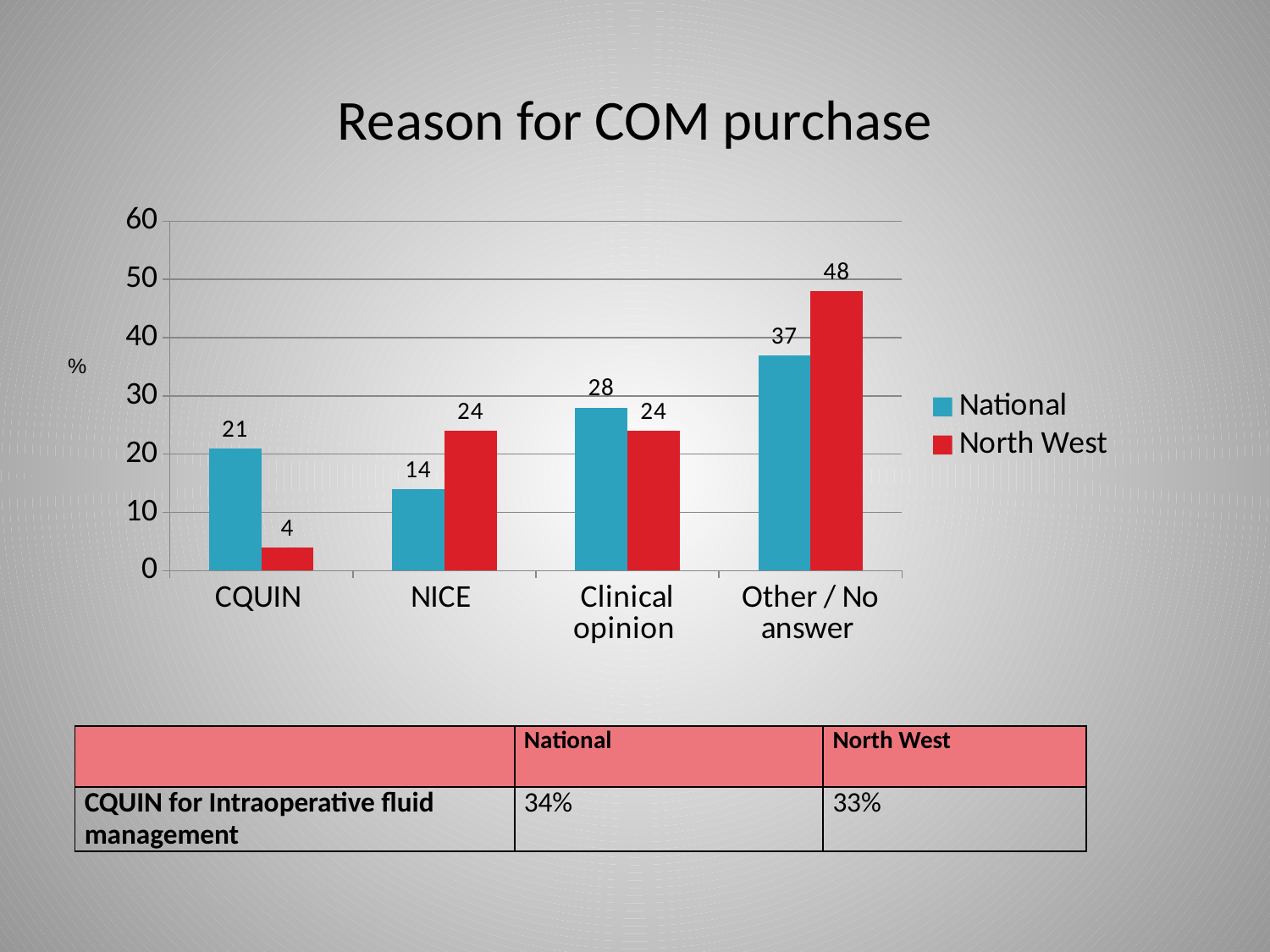
What is the North West value for Other / No answer? 48 Which category has the lowest North West value? CQUIN How many categories are shown on the x axis? 4 What kind of chart is shown on the slide? Bar chart What is the difference between the North West and National values for Other / No answer? 11 Which is larger for NICE, the National value or the North West value? North West Which category has the highest National value? Other / No answer What is the National value for CQUIN? 21 What is the difference between the National and North West values for CQUIN? 17 Which is larger for Clinical opinion, the National value or the North West value? National How many series does the legend list? 2 What is the North West value for NICE? 24